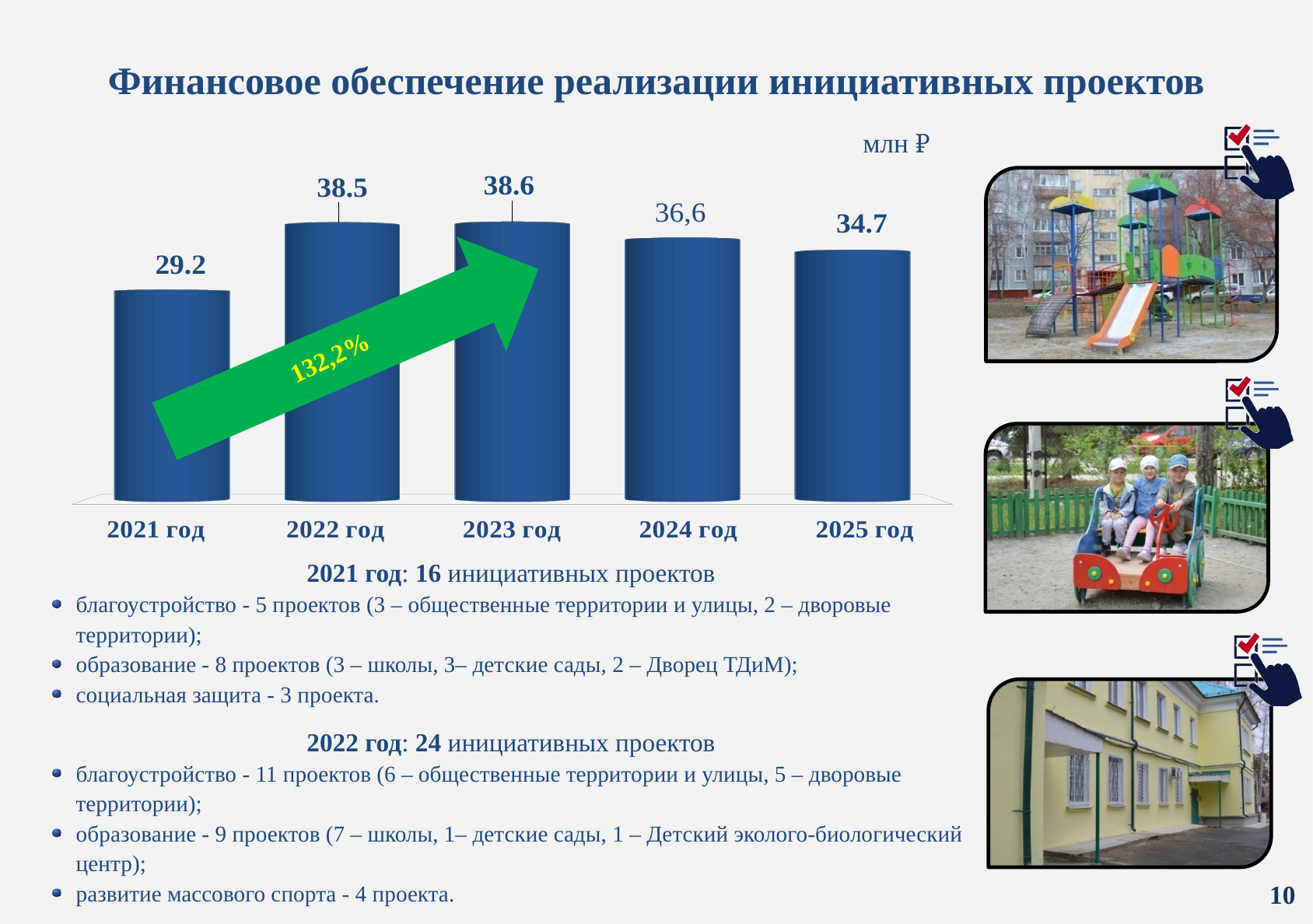
What is the value for 2022 год? 38.5 What unit is indicated for the chart values? млн ₽ Which year has the lowest value? 2021 год What is the value for 2025 год? 34.7 What is the value for 2024 год? 36,6 What kind of chart is shown on the slide? Bar chart What is the difference between the values for 2022 год and 2021 год? 9.3 Which year has the highest value? 2023 год What is the value for 2021 год? 29.2 What is the difference between the values for 2023 год and 2025 год? 3.9 Which is larger, the value for 2024 год or the value for 2025 год? 2024 год How many years are shown in the chart? 5